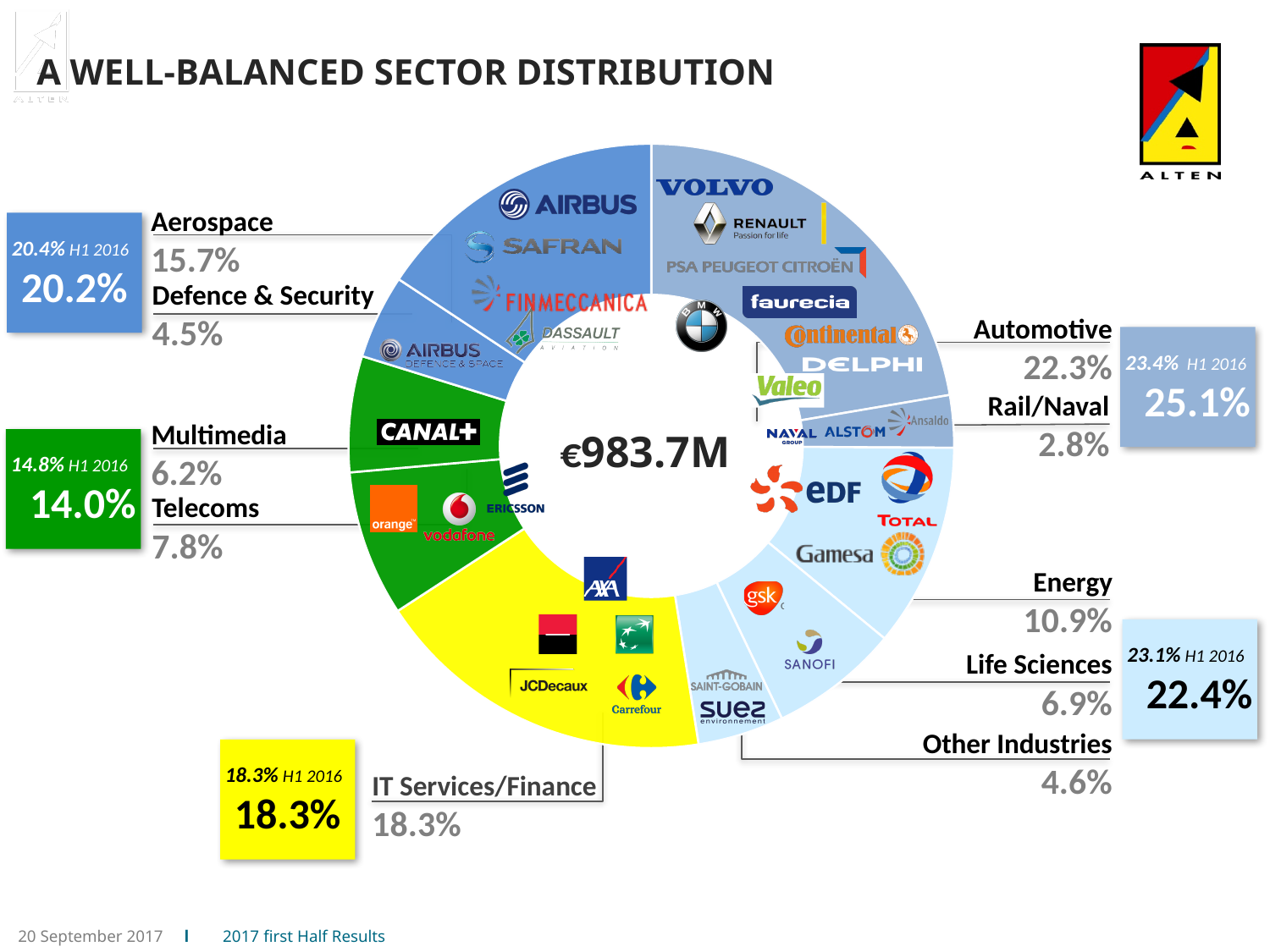
Which is larger, the share for Energy or the share for Multimedia? Energy How many sectors are labelled with a percentage around the chart? 10 What is the share for Automotive? 22.3% What total value is shown in the centre of the chart? €983.7M What kind of chart is shown on the slide? Pie chart (donut) Which sector has the smallest share? Rail/Naval What is the combined share of the Aerospace and Defence & Security group? 20.2% What is the share for Life Sciences? 6.9% Which sector has the largest share? Automotive What is the difference between the Aerospace share and the Defence & Security share? 11.2% What is the share for Telecoms? 7.8% What was the H1 2016 share for the Automotive and Rail/Naval group? 23.4%